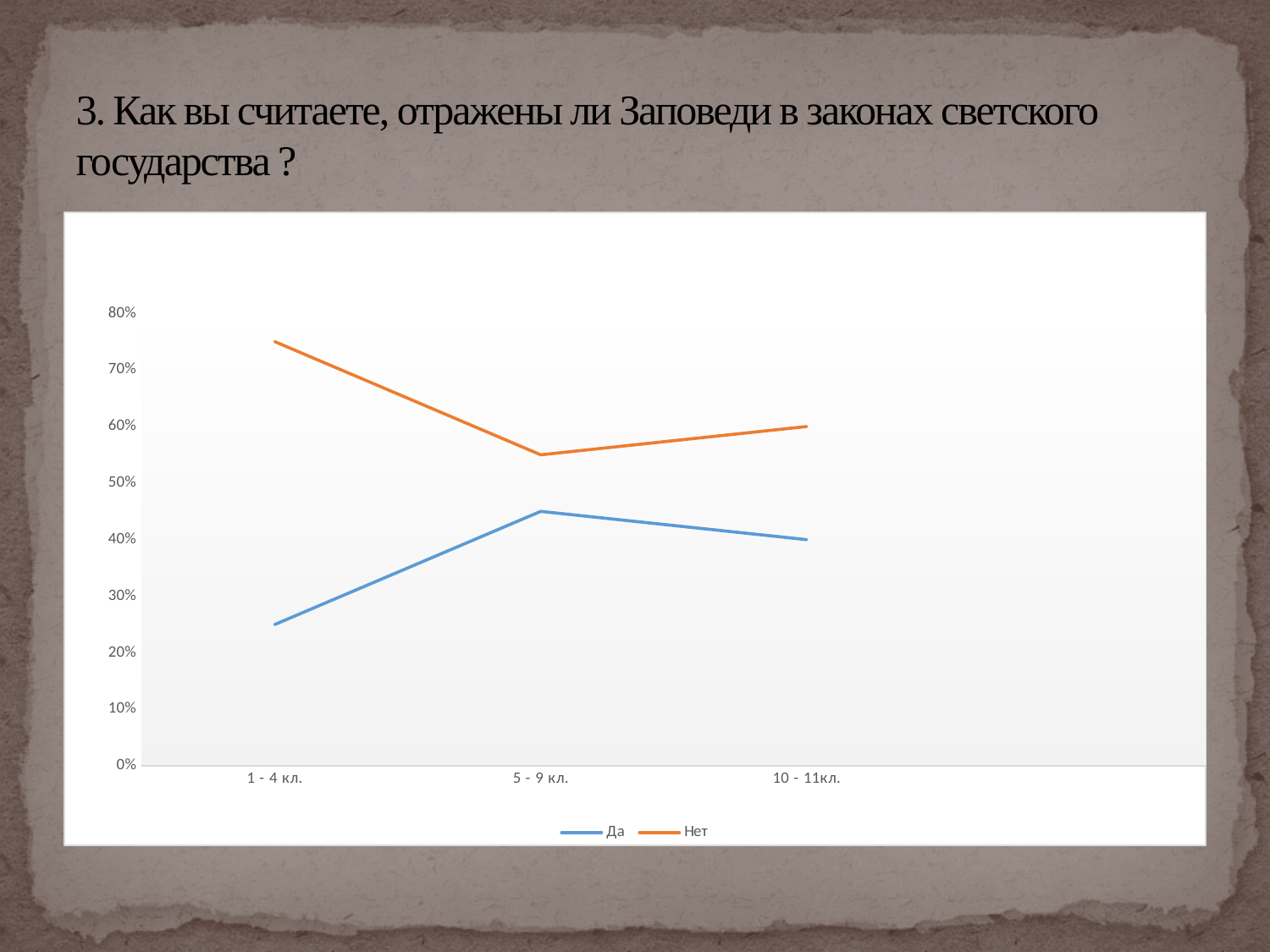
What kind of chart is shown on the slide? line chart At 10 - 11кл., which series has the larger value, Да or Нет? Нет How many series does the legend list? 2 Is the value for Нет at 5 - 9 кл. greater or less than 60%? less How many categories are shown on the x axis? 3 Which series is shown in orange? Нет Does the Нет series rise or fall from 1 - 4 кл. to 5 - 9 кл.? fall Is the value for Нет at 1 - 4 кл. greater or less than 70%? greater Is the value for Да at 1 - 4 кл. greater or less than 30%? less For which category is the Да series lowest? 1 - 4 кл. For which category is the Нет series highest? 1 - 4 кл.